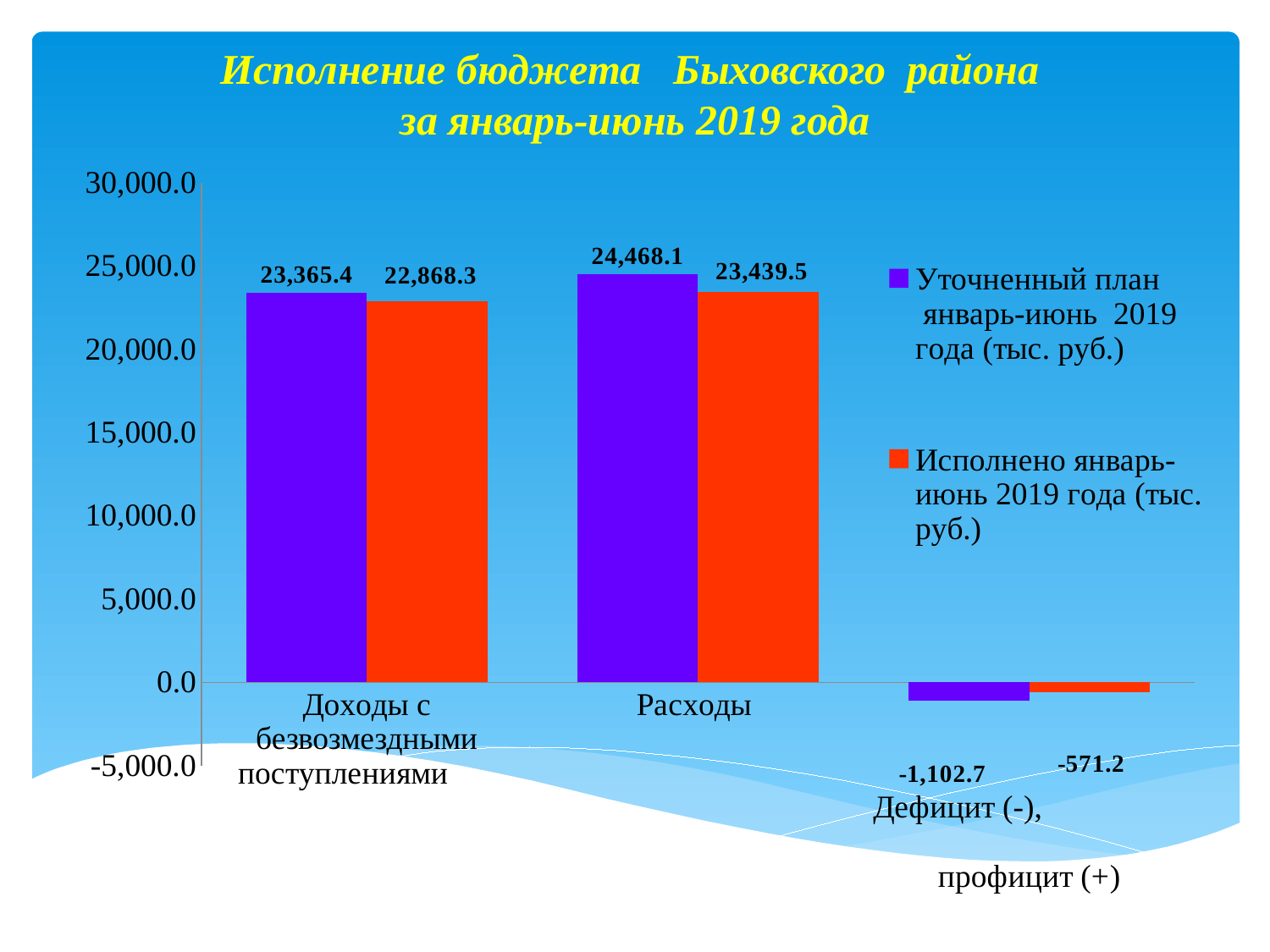
What is the value of the 'Уточненный план январь-июнь 2019 года (тыс. руб.)' series for 'Расходы'? 24,468.1 For 'Расходы', which is larger: the 'Уточненный план' value or the 'Исполнено' value? Уточненный план What is the 'Уточненный план январь-июнь 2019 года (тыс. руб.)' value for 'Дефицит (-), профицит (+)'? -1,102.7 How many series does the chart legend list? 2 Which category has the highest value in the 'Уточненный план январь-июнь 2019 года (тыс. руб.)' series? Расходы What type of chart is shown on the slide? Bar chart What is the value of the 'Исполнено январь-июнь 2019 года (тыс. руб.)' series for 'Доходы с безвозмездными поступлениями'? 22,868.3 What is the 'Исполнено январь-июнь 2019 года (тыс. руб.)' value for 'Дефицит (-), профицит (+)'? -571.2 Which category has the lowest value in the 'Исполнено январь-июнь 2019 года (тыс. руб.)' series? Дефицит (-), профицит (+) What is the difference between the planned and executed values for 'Расходы'? 1,028.6 How many categories are shown on the x axis of the chart? 3 What is the difference between the planned and executed values for 'Доходы с безвозмездными поступлениями'? 497.1